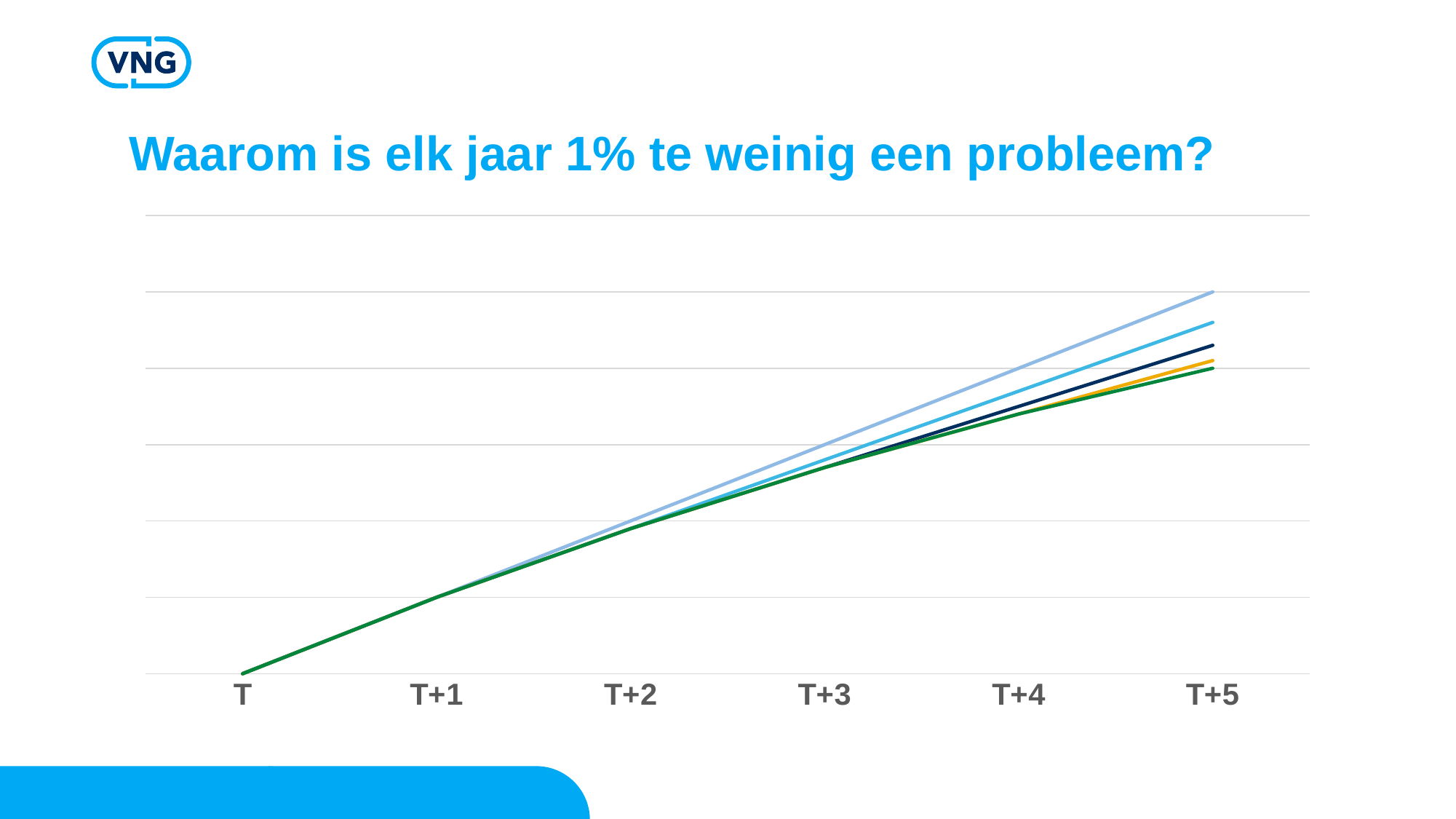
How many points are labelled on the x axis of the chart? 6 What is the first category label on the x axis? T Do the lines in the chart rise or fall from T to T+5? rise What is the title of the slide above the chart? Waarom is elk jaar 1% te weinig een probleem? How many lines are plotted in the chart? 5 Which line is lowest at T+5? the green line What kind of chart is shown on the slide? line chart What is the last category label on the x axis? T+5 At T+5, is the light blue line higher or lower than the green line? higher Which line is highest at T+5? the light blue line Do all the lines start from the same point at T? yes